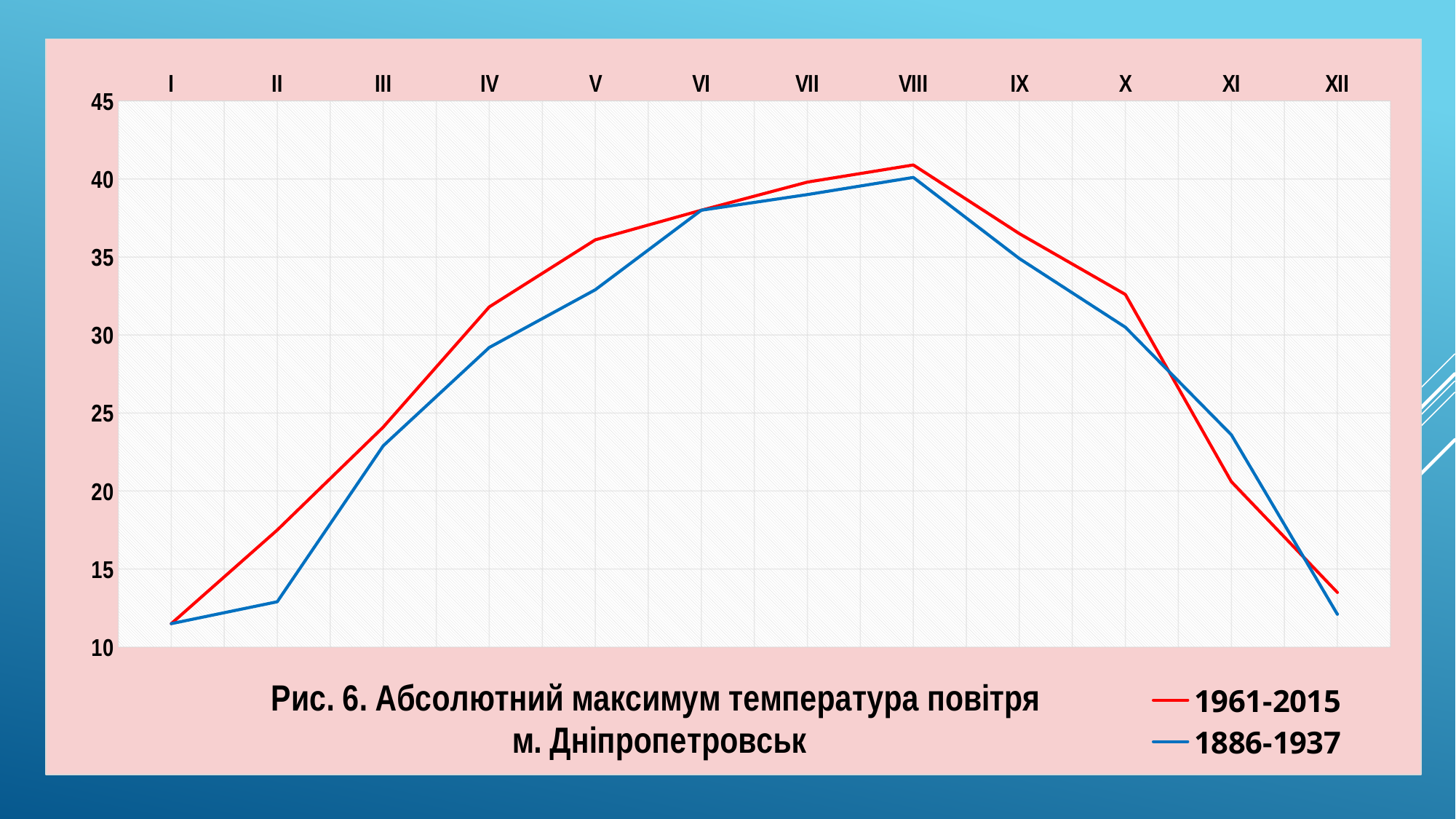
How many months (categories) are plotted along the x axis? 12 In month II, which series has the higher value, 1961-2015 or 1886-1937? 1961-2015 In month XI, which series has the higher value, 1961-2015 or 1886-1937? 1886-1937 In which month is the 1961-2015 series at its lowest value? I Does the 1961-2015 series rise or fall from month I to month VIII? rise Is the value for the 1961-2015 series in month V greater or less than 35? greater How many series does the legend list? 2 What kind of chart is shown on the slide? line chart In which month does the 1961-2015 series reach its highest value? VIII Is the value for the 1886-1937 series in month V greater or less than 35? less In which month does the 1886-1937 series reach its highest value? VIII What colour is the line for the 1886-1937 series? blue